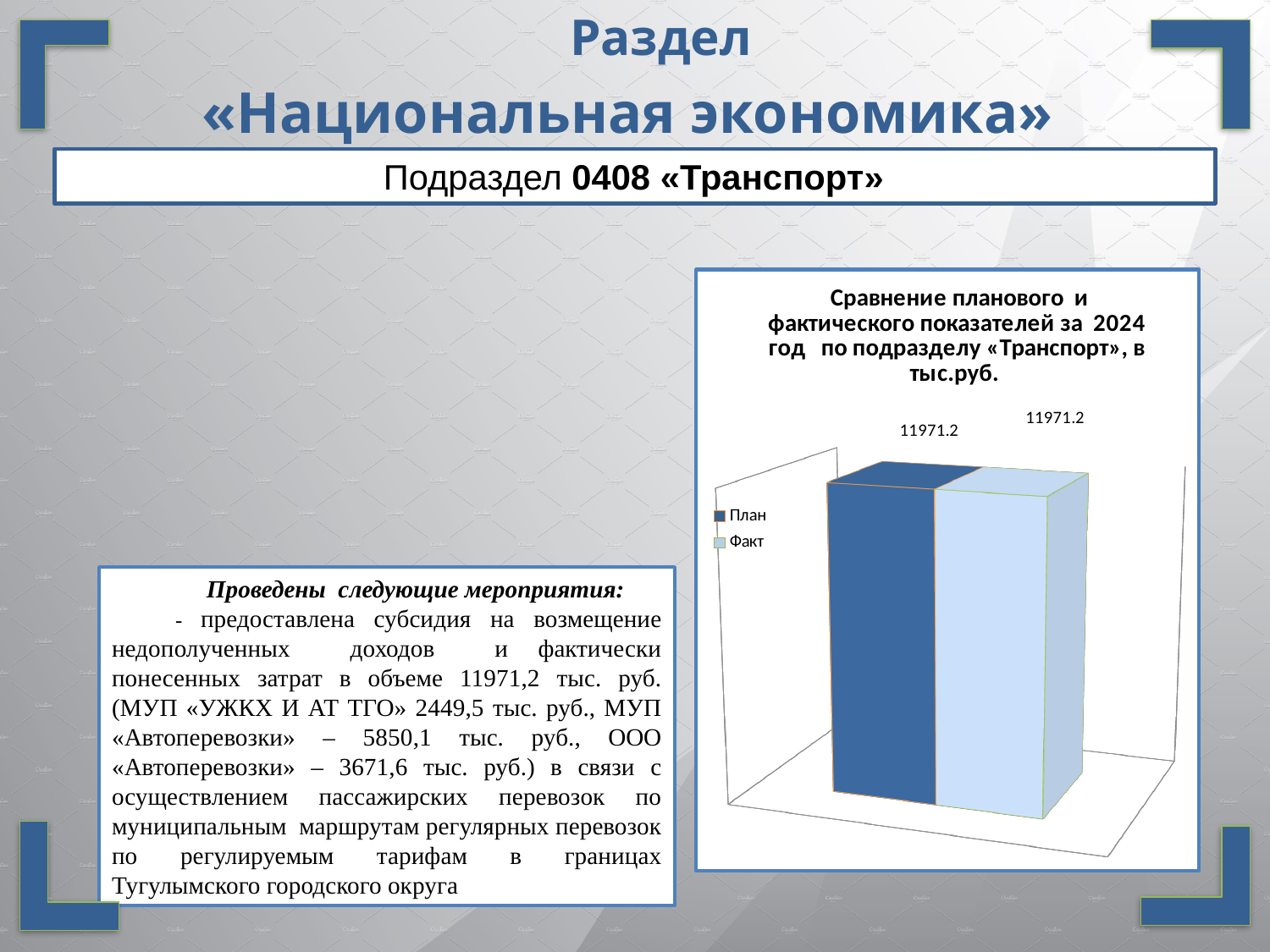
How many bars are plotted in the chart? 2 What is the value for План (plan) in the chart? 11971.2 What kind of chart is shown on the slide? bar chart How many series does the chart legend list? 2 Which year does the chart compare planned and actual indicators for? 2024 Is the План value larger than, smaller than, or equal to the Факт value? equal In what units are the values in the chart expressed, according to its title? тыс.руб. Which legend entry is shown in dark blue in the chart? План What is the value for Факт (actual) in the chart? 11971.2 What is the difference between the План and Факт values in the chart? 0 What are the two legend entries of the chart? План and Факт